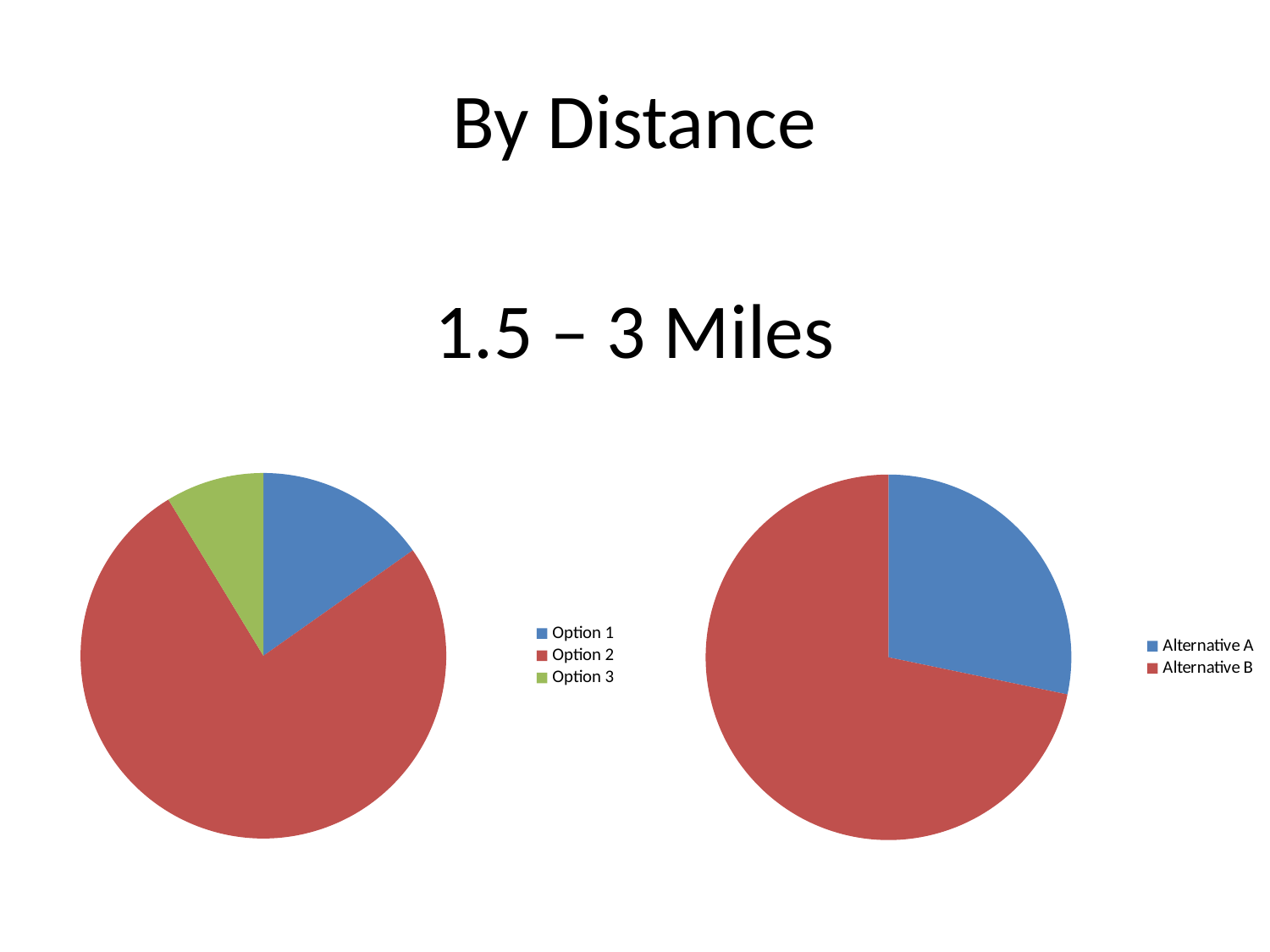
How many slices does the right pie chart have? 2 What colour is the Alternative B slice in the right pie chart? red In the right pie chart, which slice is larger, Alternative A or Alternative B? Alternative B What kind of chart is the left chart on the slide? pie chart How many entries does the legend of the left pie chart list? 3 In the left pie chart, which slice is larger, Option 1 or Option 3? Option 1 In the right pie chart, which category has the largest slice? Alternative B In the right pie chart, which category has the smallest slice? Alternative A In the left pie chart, which category has the largest slice? Option 2 What kind of chart is the right chart on the slide? pie chart In the left pie chart, which category has the smallest slice? Option 3 How many slices does the left pie chart have? 3